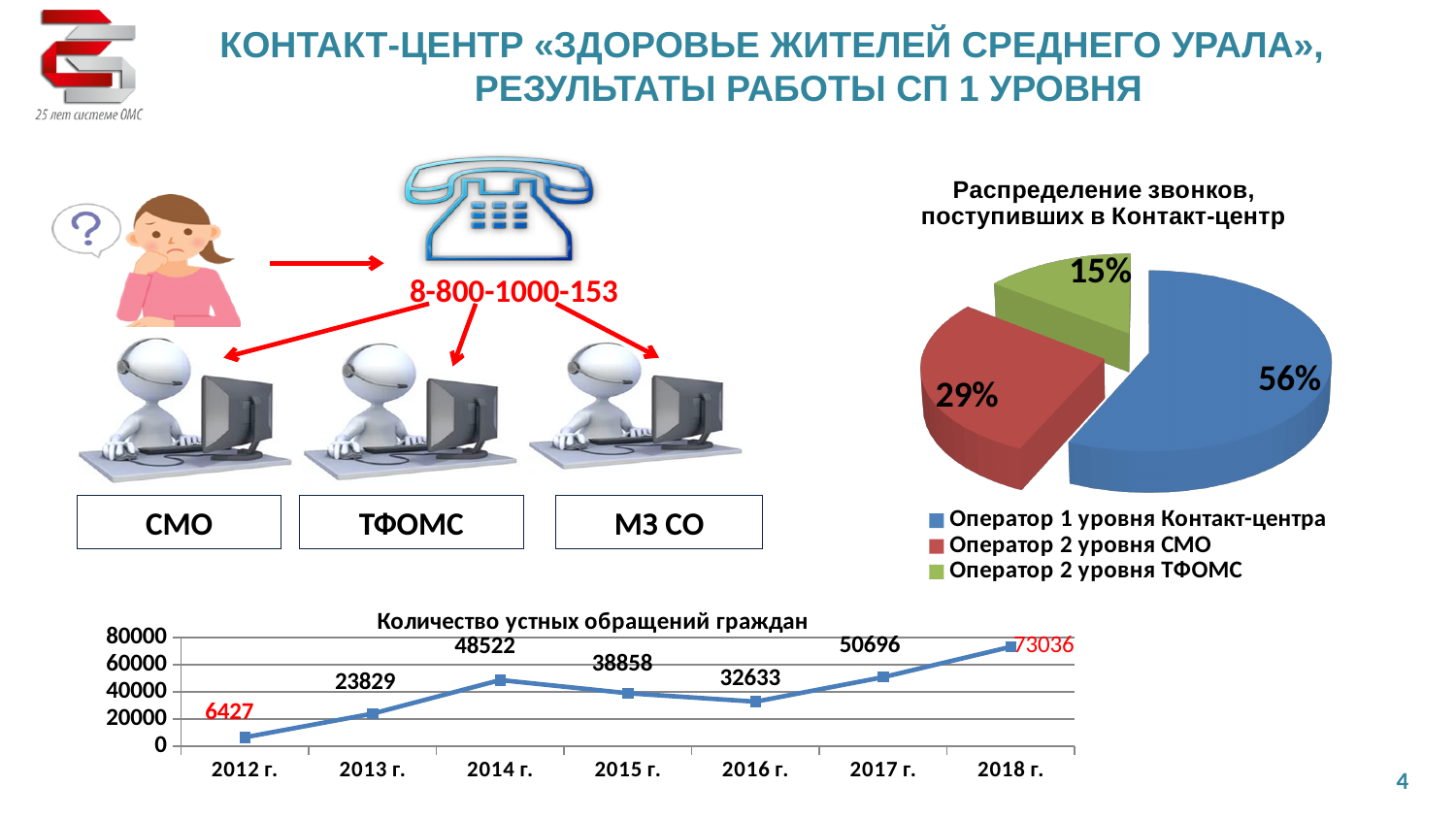
How many entries does the legend of the pie chart 'Распределение звонков, поступивших в Контакт-центр' list? 3 On the pie chart 'Распределение звонков, поступивших в Контакт-центр', which category has the smallest share? Оператор 2 уровня ТФОМС What kind of chart is 'Количество устных обращений граждан'? line chart On the chart 'Количество устных обращений граждан', what is the value for 2015 г.? 38858 On the chart 'Количество устных обращений граждан', which is larger: the value for 2014 г. or 2016 г.? 2014 г. On the chart 'Количество устных обращений граждан', which year has the lowest value? 2012 г. On the chart 'Количество устных обращений граждан', how many years are plotted? 7 On the chart 'Количество устных обращений граждан', which year has the highest value? 2018 г. On the chart 'Количество устных обращений граждан', what is the value for 2018 г.? 73036 On the chart 'Количество устных обращений граждан', what is the difference between the values for 2018 г. and 2017 г.? 22340 On the pie chart 'Распределение звонков, поступивших в Контакт-центр', what share is 'Оператор 1 уровня Контакт-центра'? 56% On the chart 'Количество устных обращений граждан', what is the value for 2012 г.? 6427